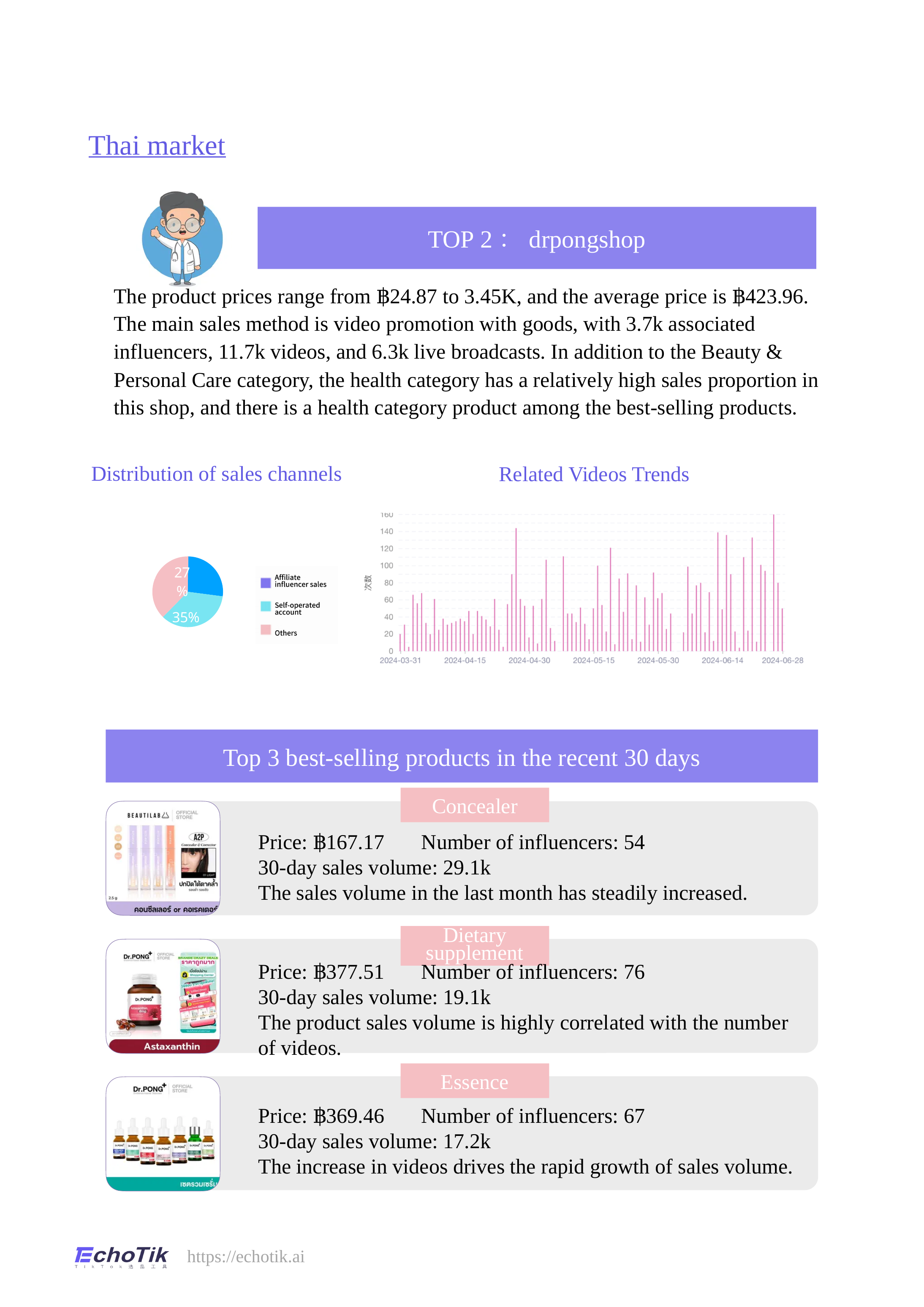
What is the highest value shown on the y axis of the 'Related Videos Trends' chart? 160 What is the last date shown on the x axis of the 'Related Videos Trends' chart? 2024-06-28 In the 'Related Videos Trends' chart, is the first bar at 2024-03-31 greater or less than 40? less How many entries does the legend of the 'Distribution of sales channels' chart list? 3 How many date labels are shown on the x axis of the 'Related Videos Trends' chart? 7 What are the legend entries of the 'Distribution of sales channels' chart? Affiliate influencer sales, Self-operated account, Others What kind of chart is the 'Related Videos Trends' chart? bar chart What kind of chart is the 'Distribution of sales channels' chart? pie chart In the 'Related Videos Trends' chart, in which month does the tallest bar occur? June 2024 In the 'Related Videos Trends' chart, is the tallest bar greater or less than 140? greater